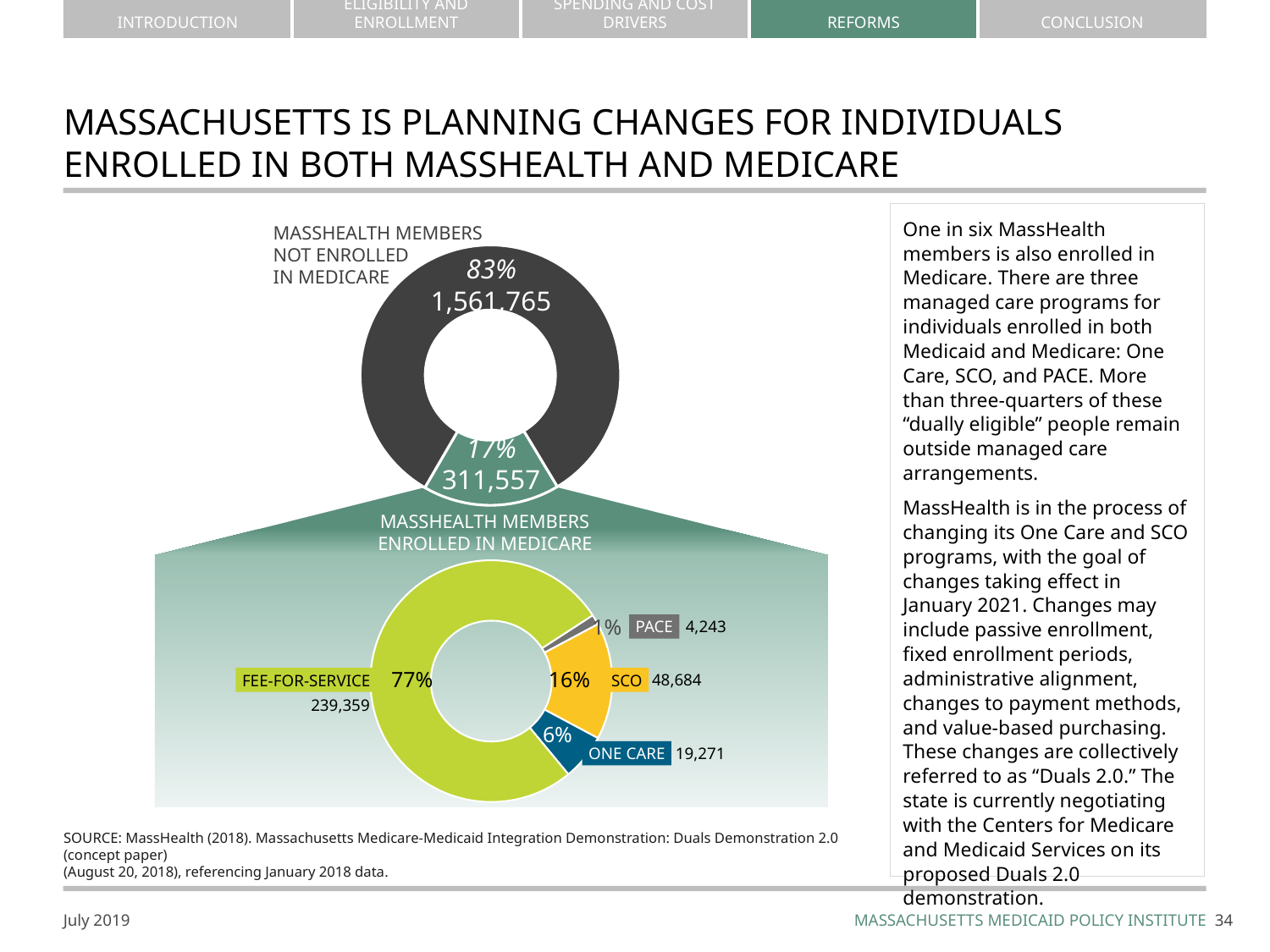
In the bottom donut chart, how many members are in SCO? 48,684 In the top donut chart, how many MassHealth members are enrolled in Medicare? 311,557 How many categories are shown in the bottom donut chart? 4 In the bottom donut chart, how many members are in One Care? 19,271 In the top donut chart, how many MassHealth members are not enrolled in Medicare? 1,561,765 In the bottom donut chart of MassHealth members enrolled in Medicare, what share is Fee-for-Service? 77% In the bottom donut chart, which has more members, SCO or PACE? SCO In the bottom donut chart, which program has the smallest number of members? PACE In the bottom donut chart, what is the difference in members between SCO and One Care? 29,413 What type of chart is used to show MassHealth members enrolled in Medicare? Donut (pie) chart In the top donut chart, what percentage of MassHealth members are not enrolled in Medicare? 83% In the bottom donut chart, which category has the largest share? Fee-for-Service